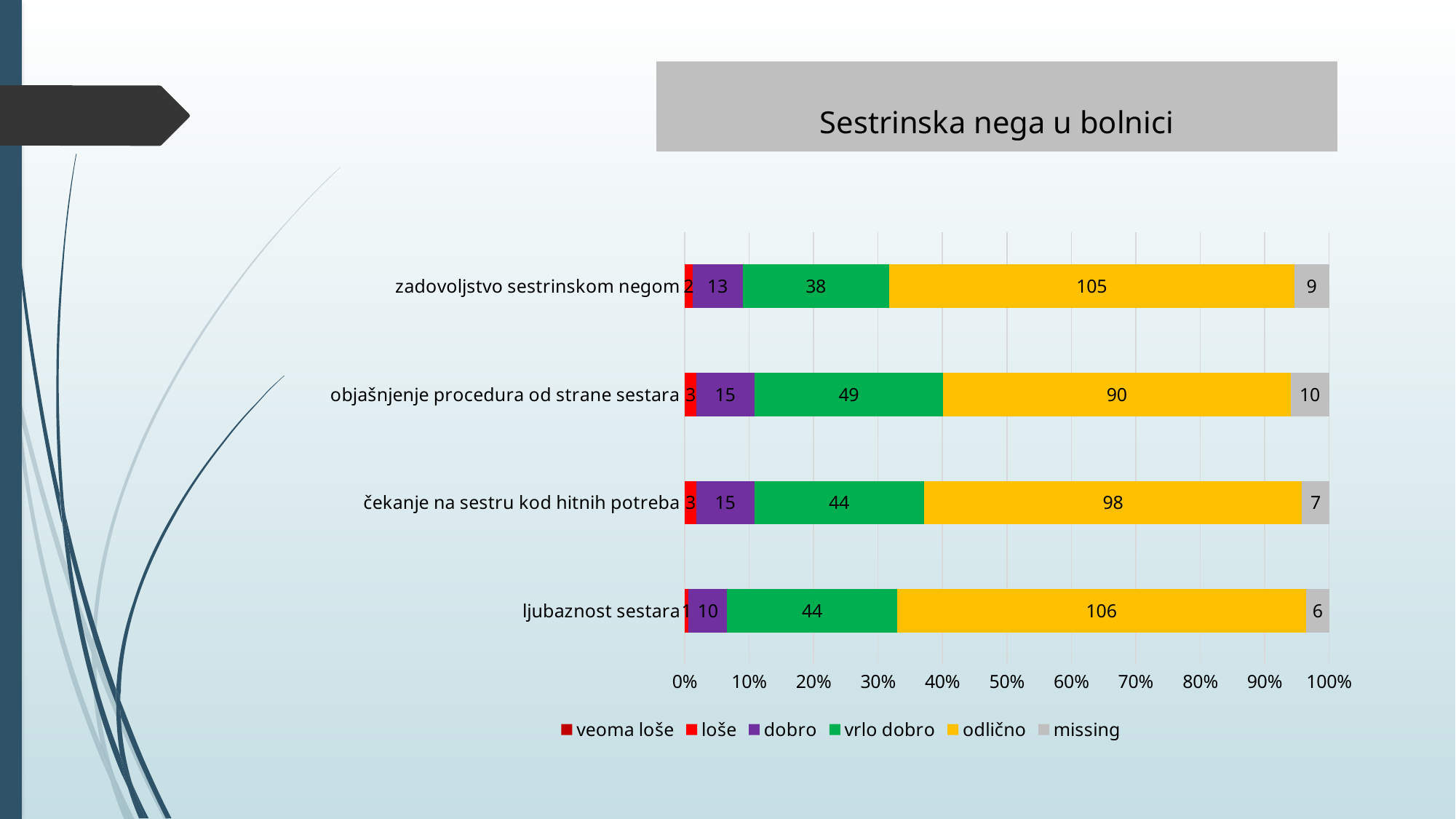
What kind of chart is shown on the slide? bar chart What is the 'odlično' value for 'zadovoljstvo sestrinskom negom'? 105 How many categories are shown on the chart? 4 Which category has the lowest 'odlično' value? objašnjenje procedura od strane sestara What is the 'missing' value for 'čekanje na sestru kod hitnih potreba'? 7 What is the difference between the 'odlično' values for 'ljubaznost sestara' and 'objašnjenje procedura od strane sestara'? 16 What is the 'vrlo dobro' value for 'objašnjenje procedura od strane sestara'? 49 What is the 'dobro' value for 'ljubaznost sestara'? 10 What is the title of the chart? Sestrinska nega u bolnici Which category has the highest 'odlično' value? ljubaznost sestara How many series does the legend list? 6 Which is larger: the 'vrlo dobro' value for 'zadovoljstvo sestrinskom negom' or for 'čekanje na sestru kod hitnih potreba'? čekanje na sestru kod hitnih potreba